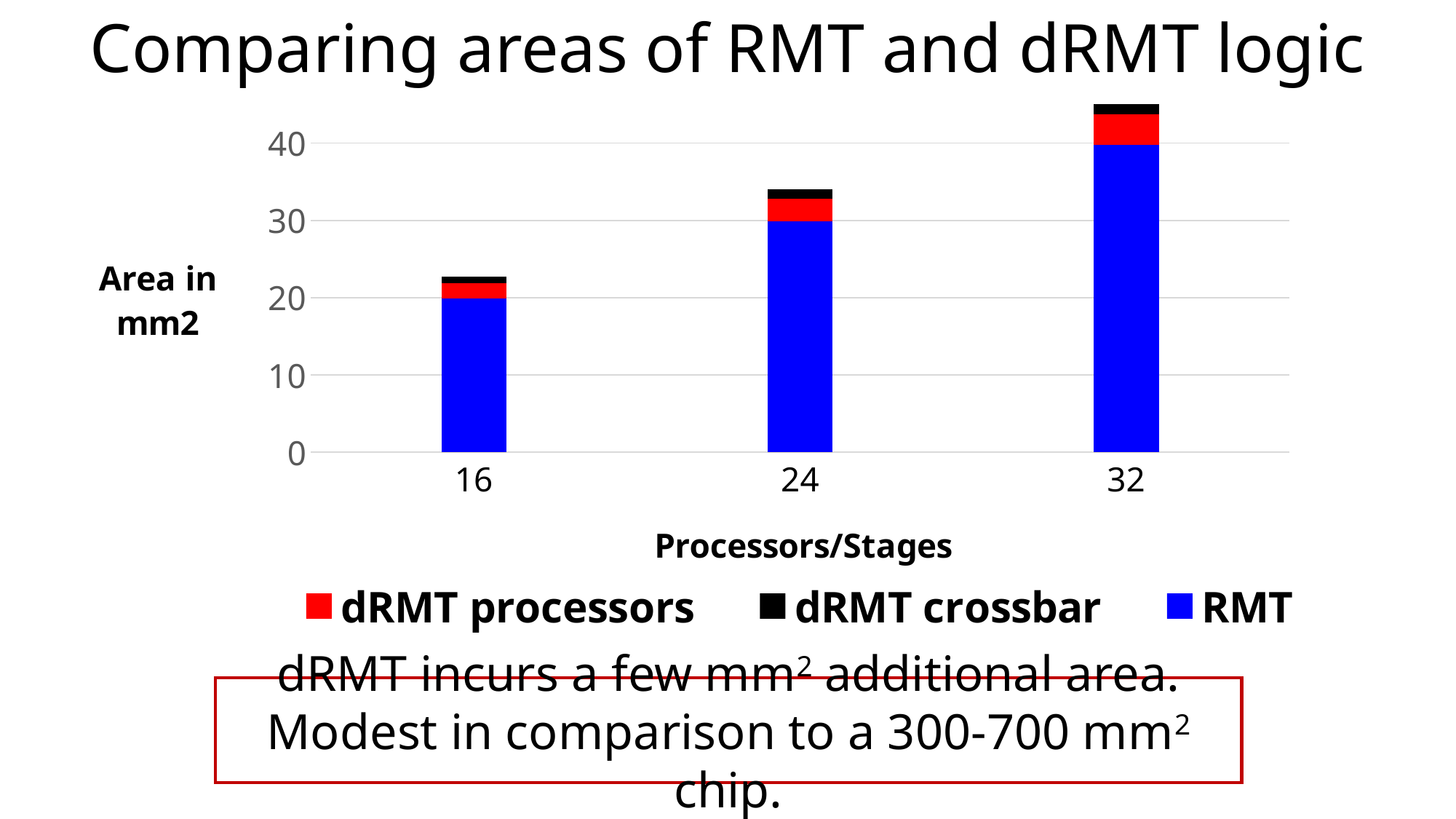
Is the total stacked bar height for 24 Processors/Stages greater or less than 30? greater How many categories are shown on the x axis of the chart? 3 Which Processors/Stages category has the shortest stacked bar? 16 Is the total stacked bar height for 32 Processors/Stages greater or less than 40? greater What is the label on the y axis of the chart? Area in mm2 Which is larger: the total bar for 24 Processors/Stages or the total bar for 16 Processors/Stages? 24 Do the total bar heights rise or fall as Processors/Stages increases from 16 to 32? Rise Which Processors/Stages category has the tallest stacked bar? 32 Is the total stacked bar height for 16 Processors/Stages greater or less than 20? greater What kind of chart is shown on the slide? Stacked bar chart How many series does the chart's legend list? 3